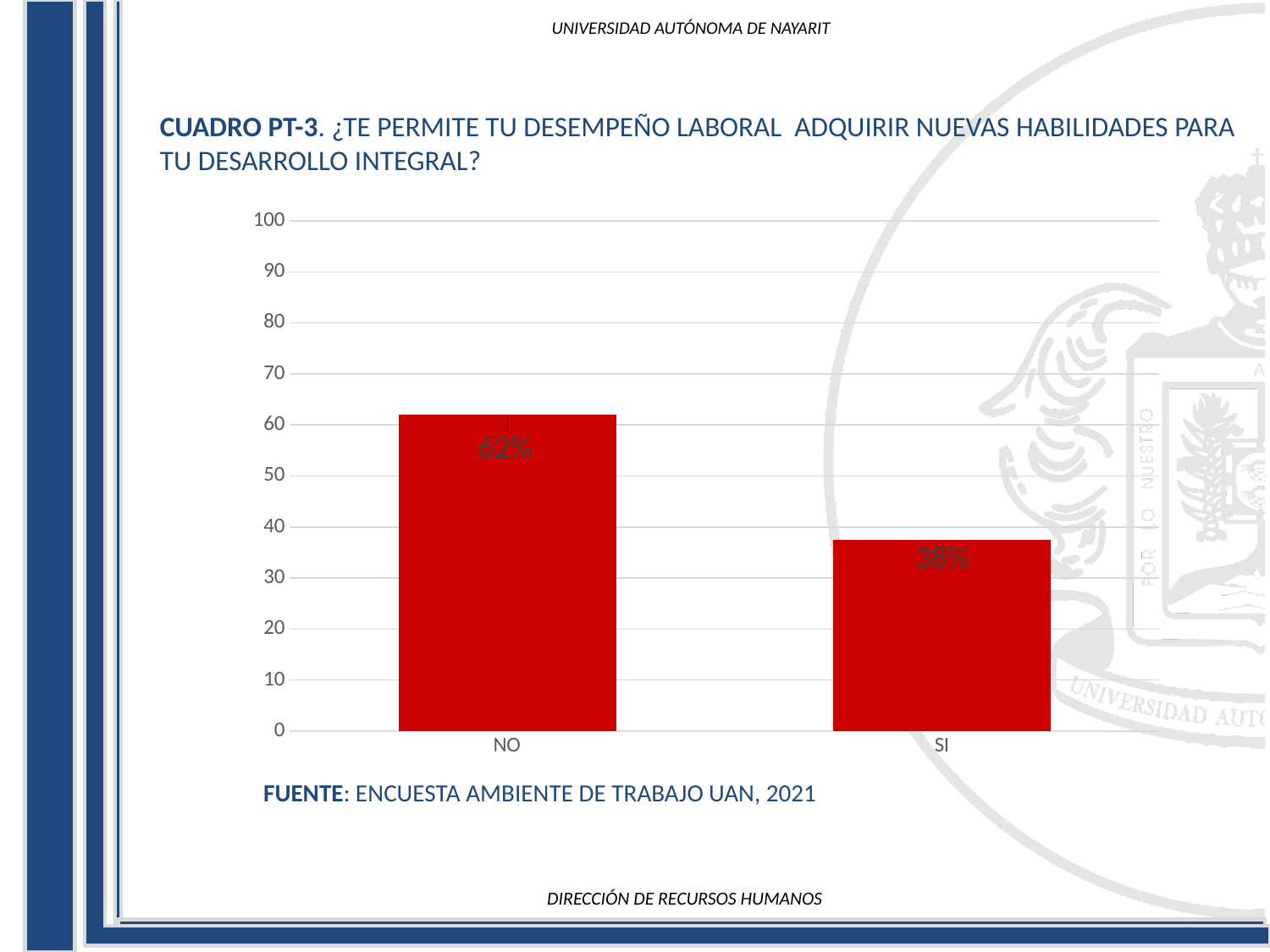
Which is larger, the value for NO or the value for SI? NO What kind of chart is shown on the slide? bar chart Which category has the highest value? NO What is the value for SI? 38% How many categories are shown on the x axis? 2 What is the difference between the values for NO and SI? 24% Is the value for SI greater or less than 40? less What colour are the bars in the chart? red Is the value for NO greater or less than 50? greater What is the highest value shown on the vertical axis? 100 Which category has the lowest value? SI What is the value for NO? 62%